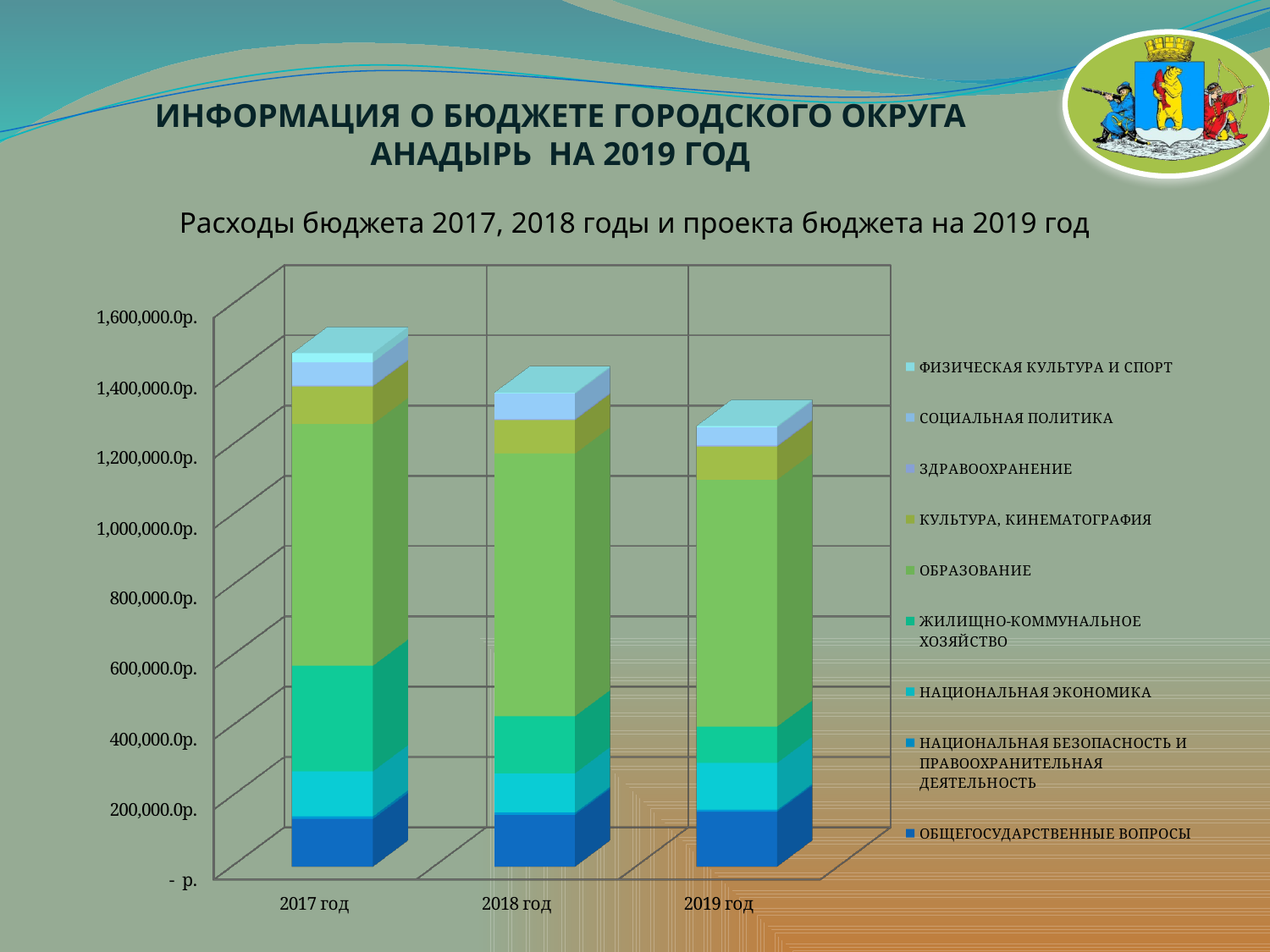
Which total is larger, the bar for 2017 год or the bar for 2019 год? 2017 год Is the total value for 2019 год greater or less than 1,400,000.0р.? less Is the total value for 2018 год greater or less than 1,600,000.0р.? less Do the total bar heights rise or fall from 2017 год to 2019 год? Fall What kind of chart is shown on the slide? Stacked bar chart Which year has the highest total budget expenditure bar? 2017 год Which year has the lowest total budget expenditure bar? 2019 год Which series forms the largest segment in each stacked bar? ОБРАЗОВАНИЕ How many years (categories) are shown on the x axis of the chart? 3 Is the total value for 2017 год greater or less than 1,200,000.0р.? greater How many series does the chart's legend list? 9 What is the title of the chart? Расходы бюджета 2017, 2018 годы и проекта бюджета на 2019 год